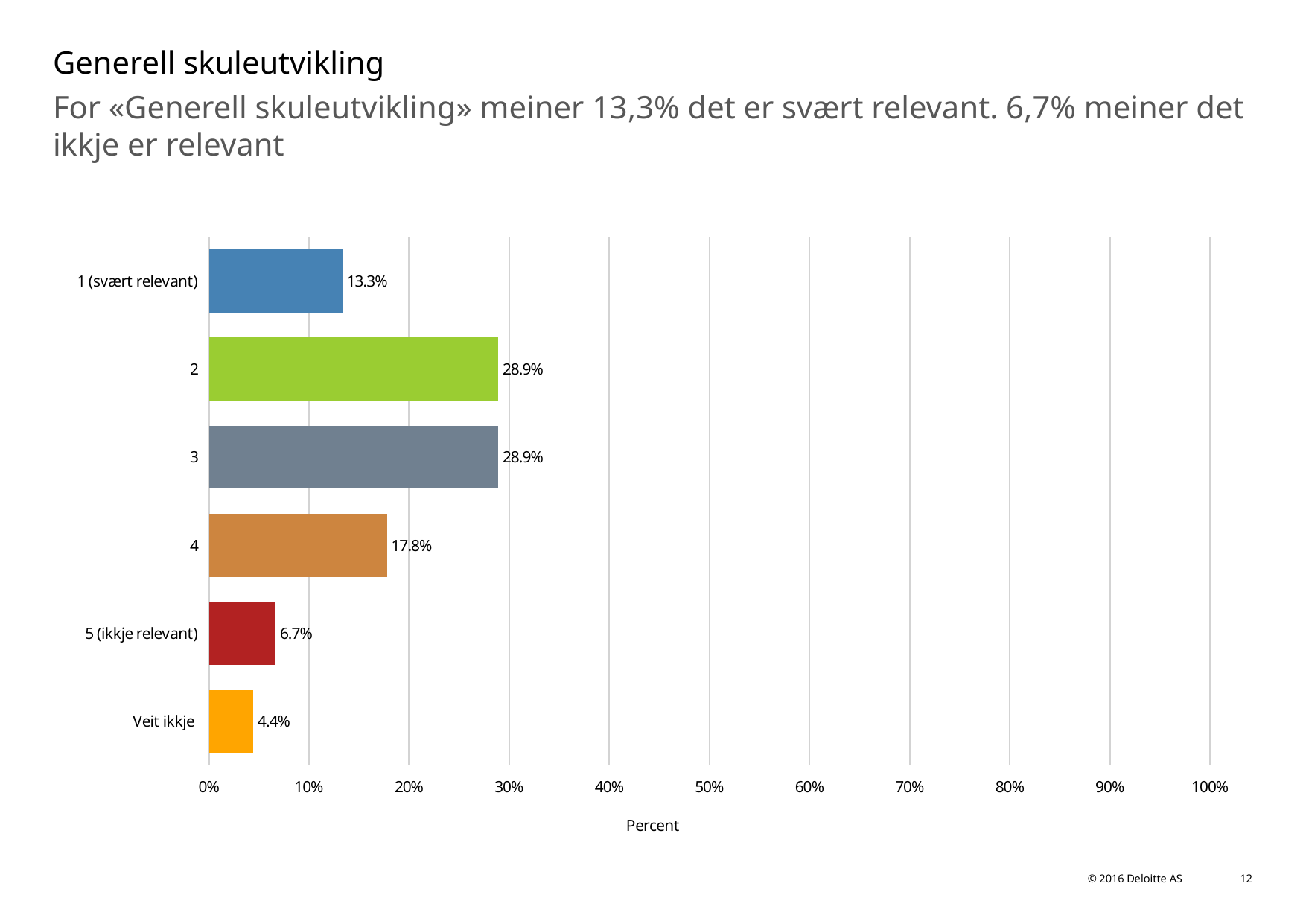
Which is larger, the value for "4" or the value for "1 (svært relevant)"? 4 What is the value for "5 (ikkje relevant)"? 6.7% Is the value for "3" greater or less than 20%? greater What is the value for "1 (svært relevant)"? 13.3% What kind of chart is shown on the slide? Bar chart What is the difference between the values for "2" and "5 (ikkje relevant)"? 22.2% Which category has the lowest value? Veit ikkje What is the difference between the values for "4" and "1 (svært relevant)"? 4.5% What is the label of the horizontal axis? Percent How many categories are shown in the chart? 6 What is the value for category "4"? 17.8% What is the value for "Veit ikkje"? 4.4%